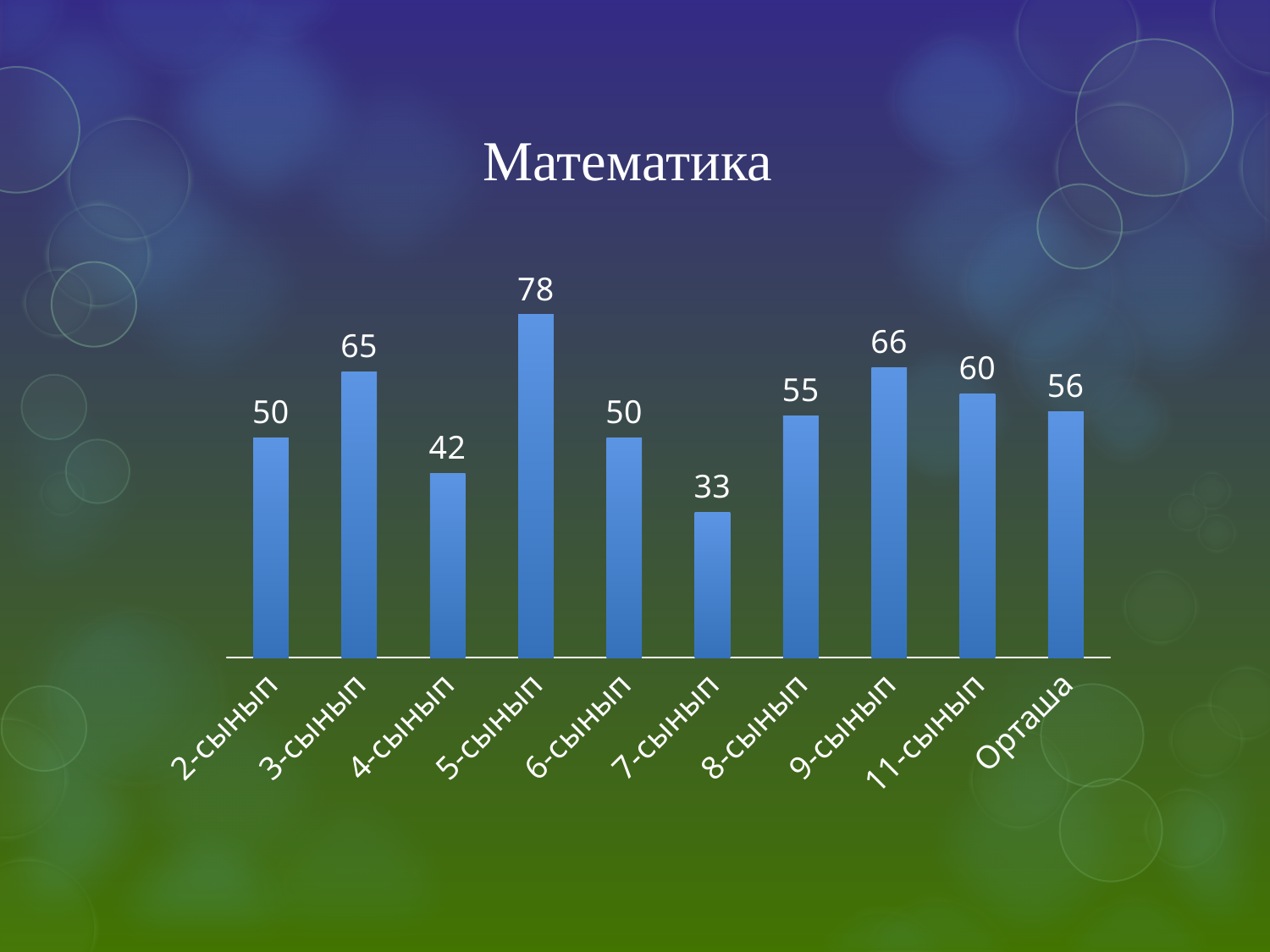
How many categories are shown on the x axis? 10 What is the value for 11-сынып? 60 What kind of chart is shown on the slide? bar chart Which category has the highest value? 5-сынып Which category has the lowest value? 7-сынып What is the value for 7-сынып? 33 What is the title of the chart? Математика Which is larger, the value for 3-сынып or the value for 4-сынып? 3-сынып What is the value for Орташа? 56 What is the difference between the values for 5-сынып and 7-сынып? 45 What is the value for 5-сынып? 78 What is the difference between the values for 9-сынып and 8-сынып? 11